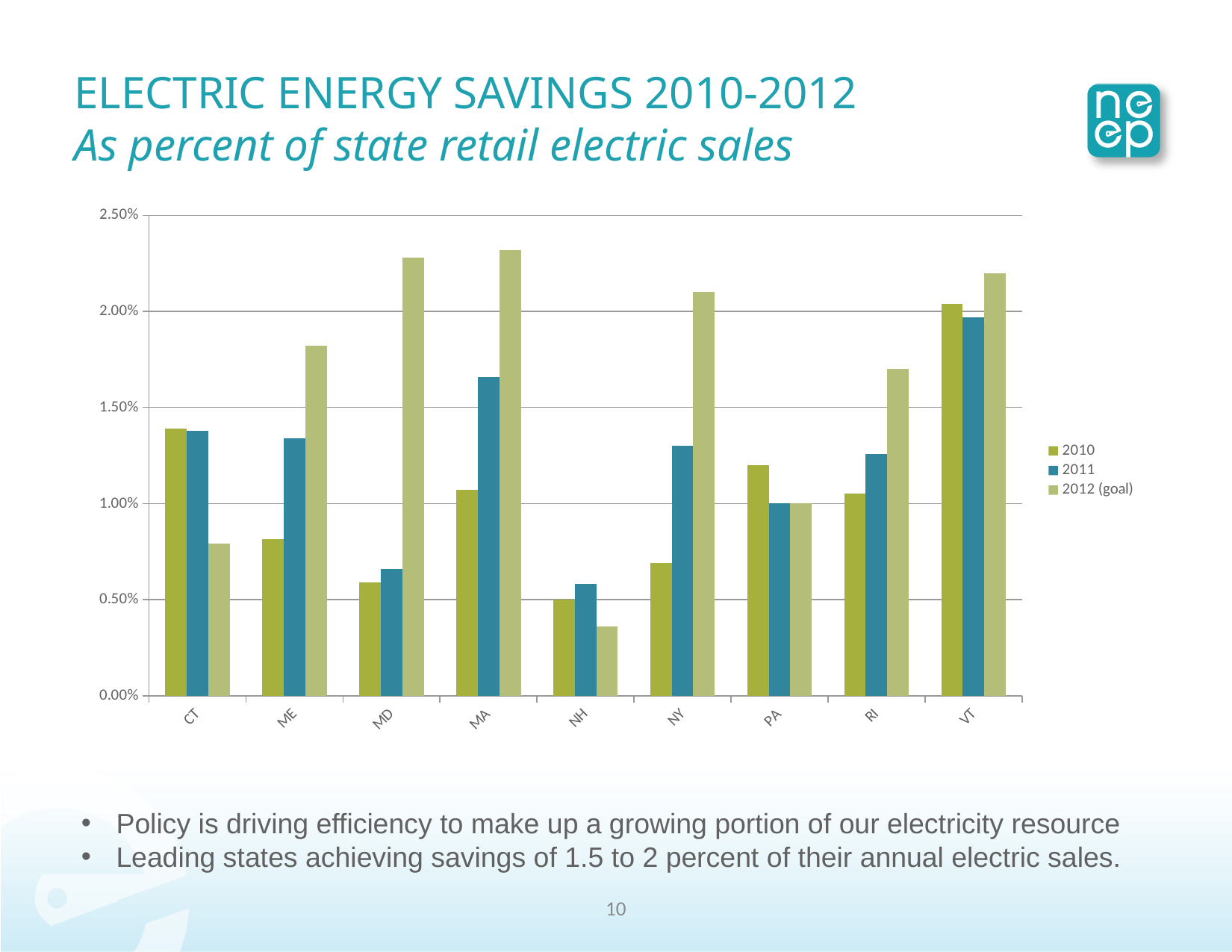
Which state has the highest 2011 value? VT Is the 2012 (goal) value for MD greater or less than 2.00%? greater Is the 2010 value for ME greater or less than 1.00%? less Which is larger, the 2011 value for MA or the 2011 value for NY? MA Is the 2012 (goal) value for NH greater or less than 0.50%? less What are the three series listed in the legend? 2010, 2011, 2012 (goal) Which state has the highest 2010 value? VT How many states are shown on the x axis of the chart? 9 What kind of chart is shown on the slide? bar chart Which is larger, the 2010 value for CT or the 2010 value for ME? CT Which state has the lowest 2012 (goal) value? NH How many series does the chart's legend list? 3